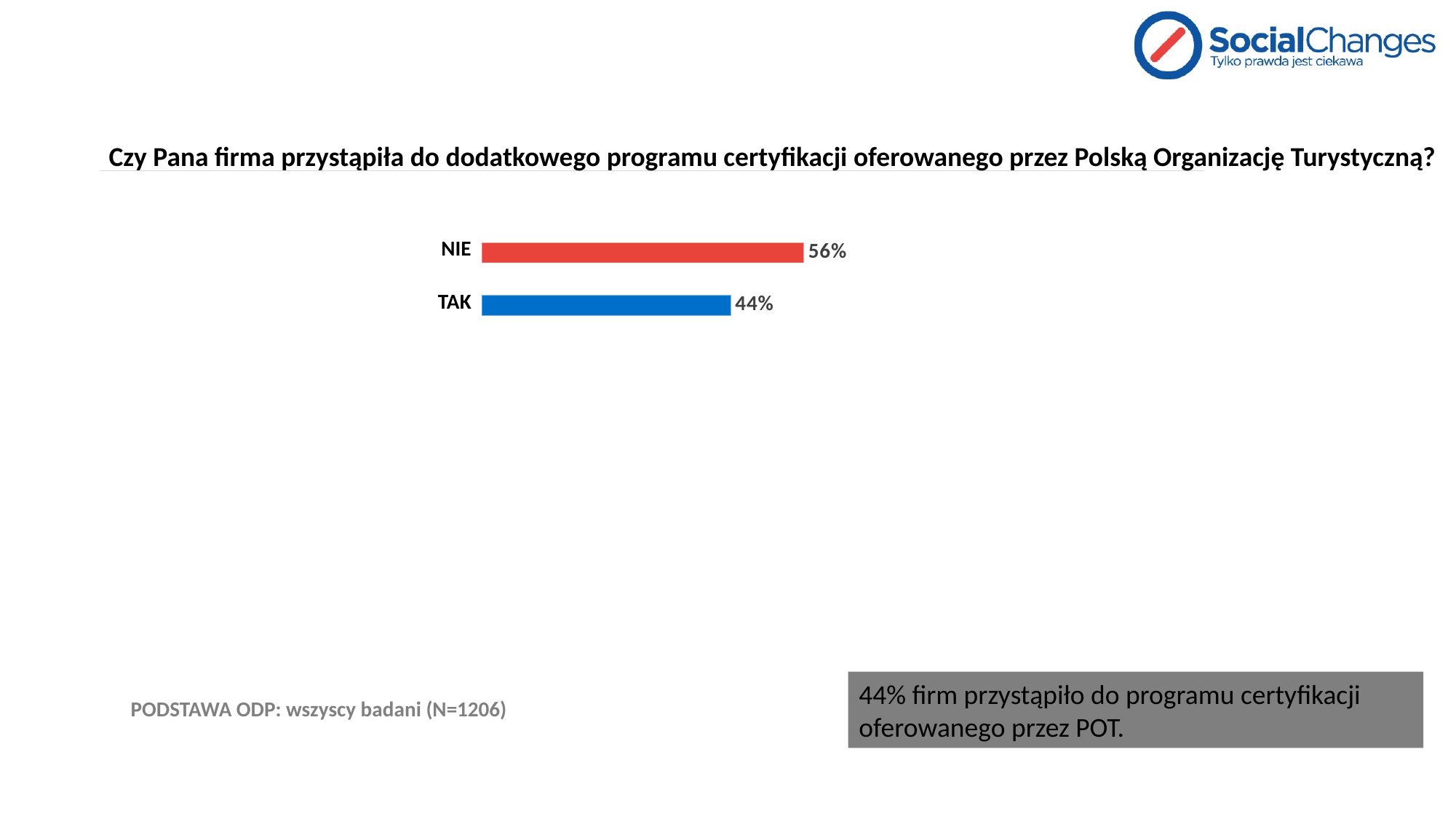
What colour is the bar for NIE? red What is the value for NIE? 56% What colour is the bar for TAK? blue What kind of chart is shown on the slide? bar chart Which category has the highest value? NIE What is the total of the values for NIE and TAK? 100% Which category has the lowest value? TAK What is the value for TAK? 44% How many categories are shown in the chart? 2 What is the difference between the values for NIE and TAK? 12% Which is larger, the value for NIE or the value for TAK? NIE